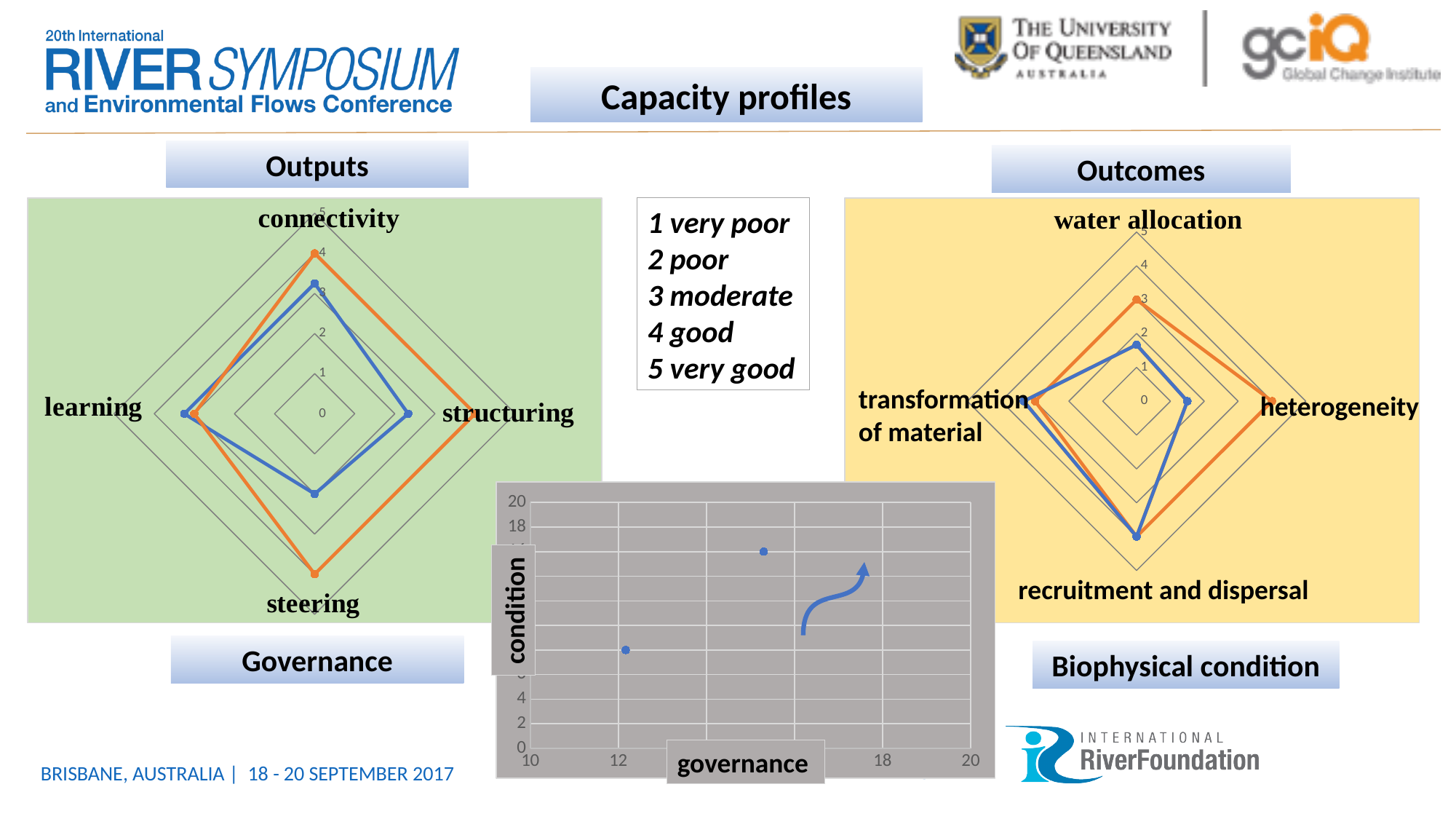
In the Outcomes radar chart on the right, which series has the larger value for heterogeneity, orange or blue? orange What kind of chart is the grey chart in the middle of the slide with axes governance and condition? scatter chart What kind of chart is the Outputs chart on the left of the slide? radar chart How many data points are plotted in the middle scatter chart of condition against governance? 2 In the Outputs radar chart on the left, is the blue series value for structuring greater or less than 3? less In the Outcomes radar chart on the right, is the blue series value for heterogeneity greater or less than 2? less In the Outputs radar chart on the left, which series has the larger value for steering, orange or blue? orange In the Outputs radar chart on the left, is the orange series value for steering greater or less than 3? greater How many categories (axes) does the Outputs radar chart on the left have? 4 How many categories (axes) does the Outcomes radar chart on the right have? 4 What is the label of the vertical axis of the middle scatter chart? condition